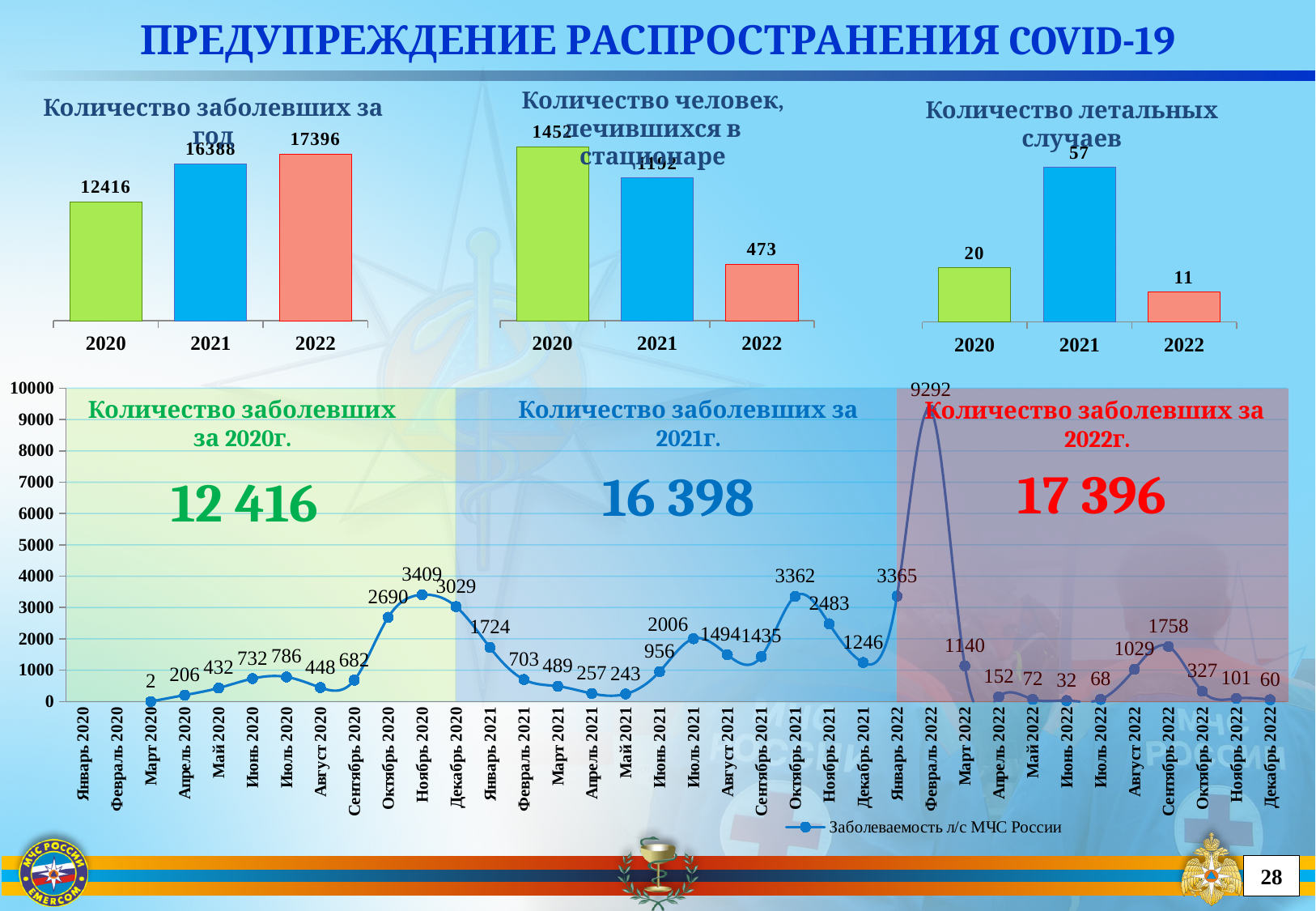
In the chart 'Количество заболевших за год', what is the difference between the 2022 and 2020 values? 4980 In the chart 'Количество летальных случаев', which year has the lowest value? 2022 In the chart 'Количество заболевших за год', what is the value for 2021? 16388 In the chart 'Количество заболевших за год', which year has the highest value? 2022 In the chart 'Количество летальных случаев', what is the difference between the 2021 and 2020 values? 37 In the bottom line chart, which is larger: the value for Октябрь 2021 or the value for Июль 2021? Октябрь 2021 In the bottom line chart, what is the value for Февраль 2022? 9292 What type of chart is the bottom chart on the slide? line chart In the chart 'Количество летальных случаев', what is the value for 2021? 57 What is the legend entry of the bottom line chart? Заболеваемость л/с МЧС России In the bottom line chart, what is the value for Ноябрь 2020? 3409 In the chart 'Количество человек, лечившихся в стационаре', what is the value for 2022? 473